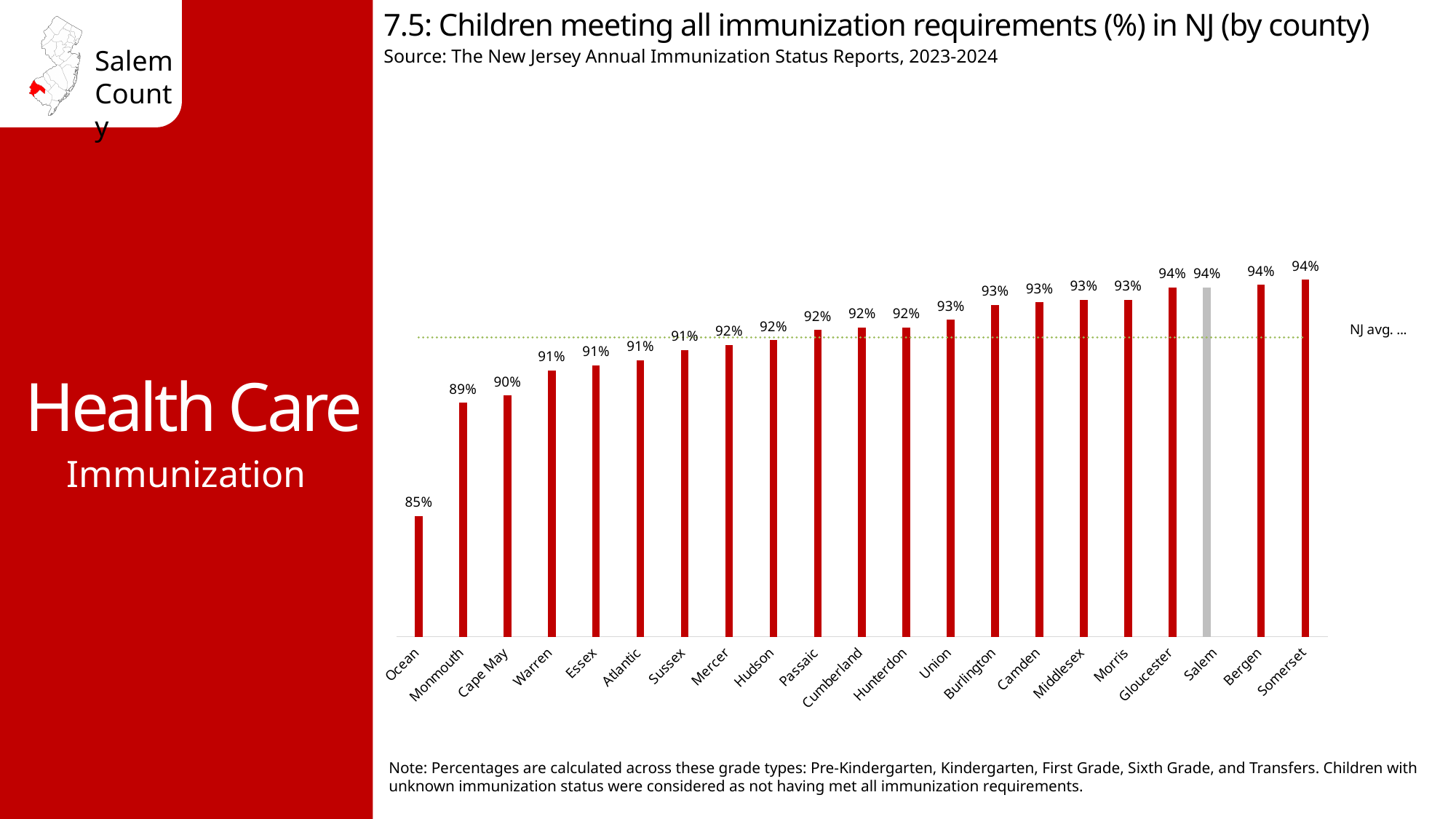
Do the values generally rise or fall moving from left to right along the x axis? Rise What kind of chart is shown on the slide? Bar chart What is the value shown for Cape May County? 90% What is the value shown for Monmouth County? 89% Which county has the lowest percentage of children meeting all immunization requirements? Ocean What percentage of children in Salem County met all immunization requirements? 94% Which has a higher value, Ocean County or Cape May County? Cape May What is the difference in percentage points between Somerset County and Ocean County? 9 percentage points What is the value shown for Ocean County? 85% What is the difference in percentage points between Salem County and Monmouth County? 5 percentage points How many counties are shown on the chart? 21 What is the value shown for Hunterdon County? 92%